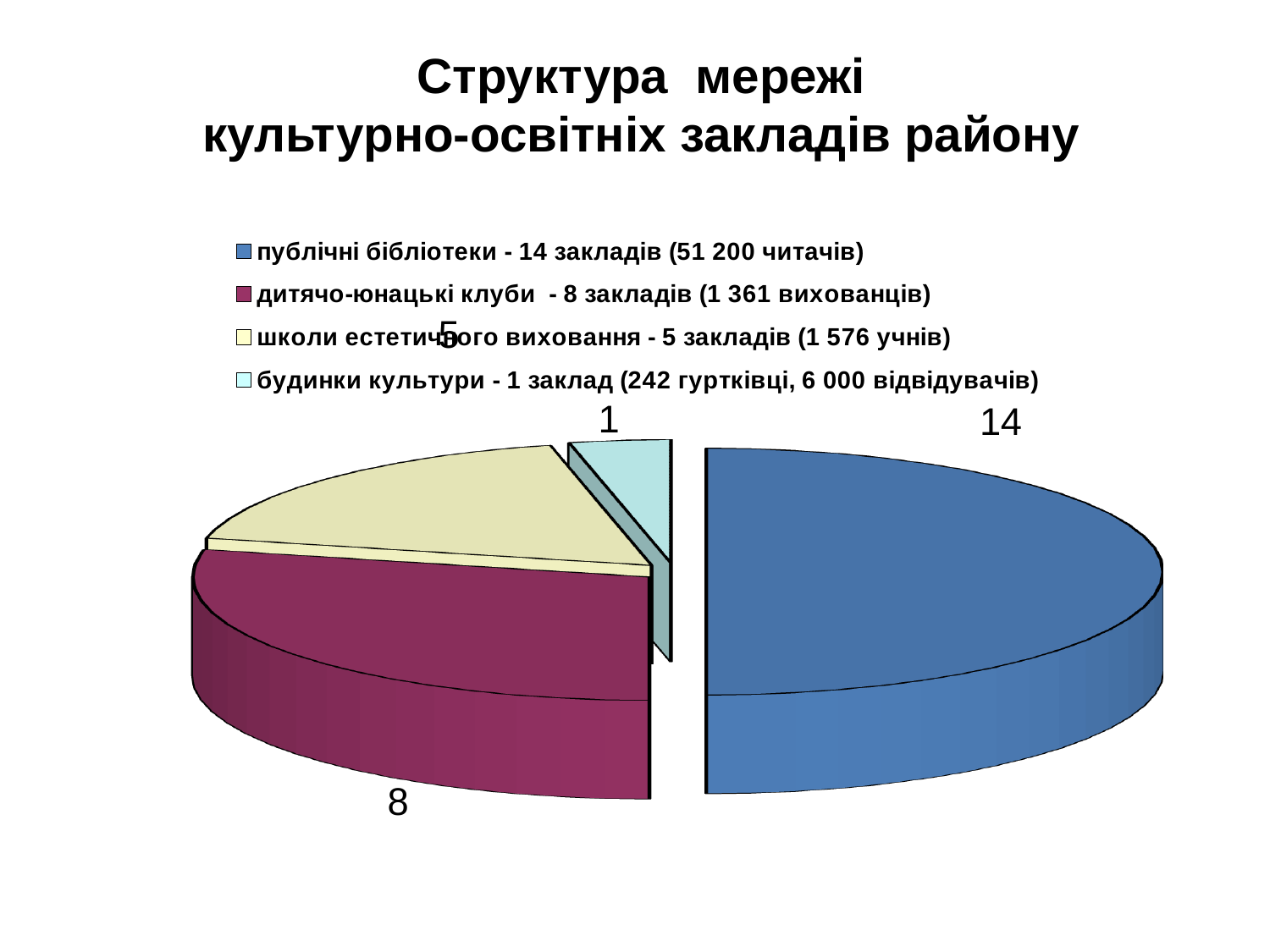
What share of the whole pie does the 'публічні бібліотеки' slice represent? 50% What value is shown for the slice 'дитячо-юнацькі клуби'? 8 How many slices does the pie chart have? 4 What value is shown for the slice 'публічні бібліотеки'? 14 What value is shown for the slice 'школи естетичного виховання'? 5 Which category has the smallest slice of the pie? будинки культури What kind of chart is shown on the slide? pie chart Which category has the largest slice of the pie? публічні бібліотеки Which is larger, the value for 'дитячо-юнацькі клуби' or for 'школи естетичного виховання'? дитячо-юнацькі клуби What value is shown for the slice 'будинки культури'? 1 What is the difference between the values for 'публічні бібліотеки' and 'дитячо-юнацькі клуби'? 6 How many entries does the legend list? 4